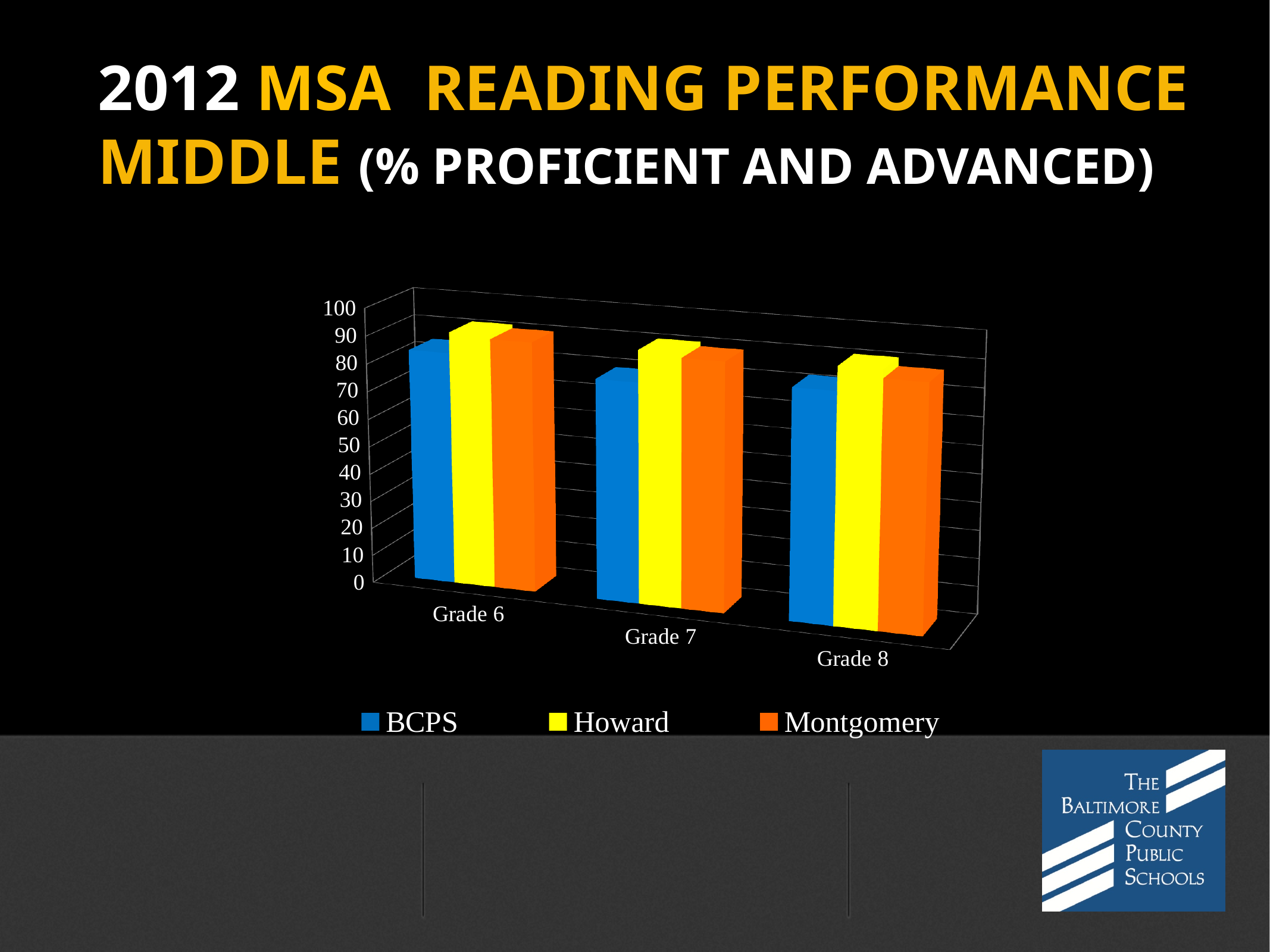
For Grade 7, which is larger: the value for BCPS or the value for Howard? Howard Which series has the lowest value for Grade 8? BCPS Is the value for BCPS in Grade 6 greater or less than 80? greater Is the value for Howard in Grade 7 greater or less than 80? greater How many grade categories are shown on the x axis? 3 Which colour represents Montgomery in the legend? orange Is the value for Montgomery in Grade 8 greater or less than 90? less How many series does the legend list? 3 What kind of chart is shown on the slide? bar chart Which series has the highest value for Grade 6? Howard